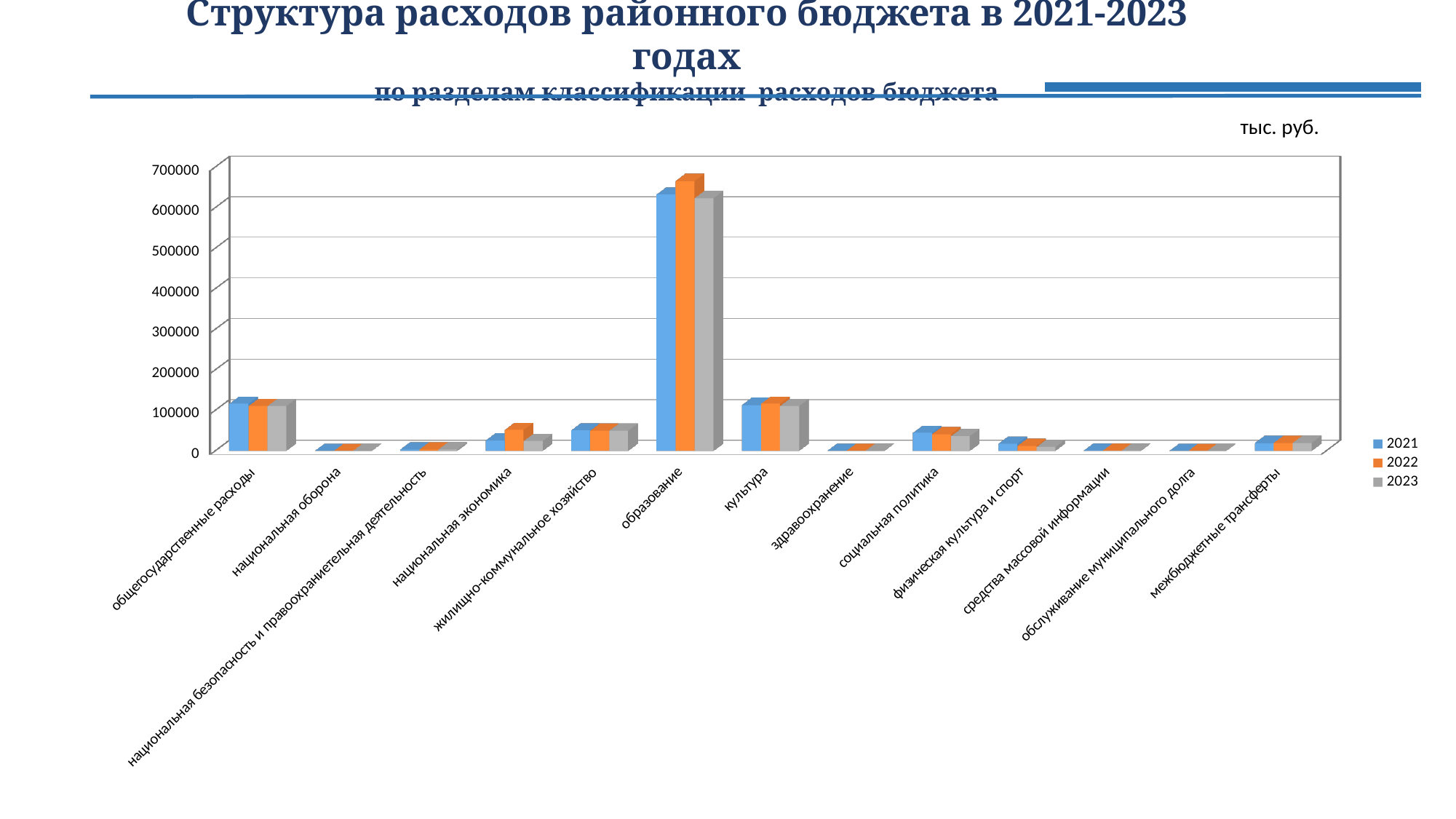
How many series does the legend list? 3 Is the 2023 value for образование greater or less than 500000? greater What kind of chart is shown on the slide? bar chart Which is larger in 2022: образование or культура? образование Which category has the highest expenditure in 2022? образование Which category has the highest expenditure in 2021? образование Is the 2021 value for общегосударственные расходы greater or less than 200000? less Is the 2022 value for образование greater or less than 600000? greater How many expenditure categories are shown along the x axis? 13 What unit of measurement is indicated above the chart? тыс. руб. For национальная экономика, which year has the larger value: 2021 or 2022? 2022